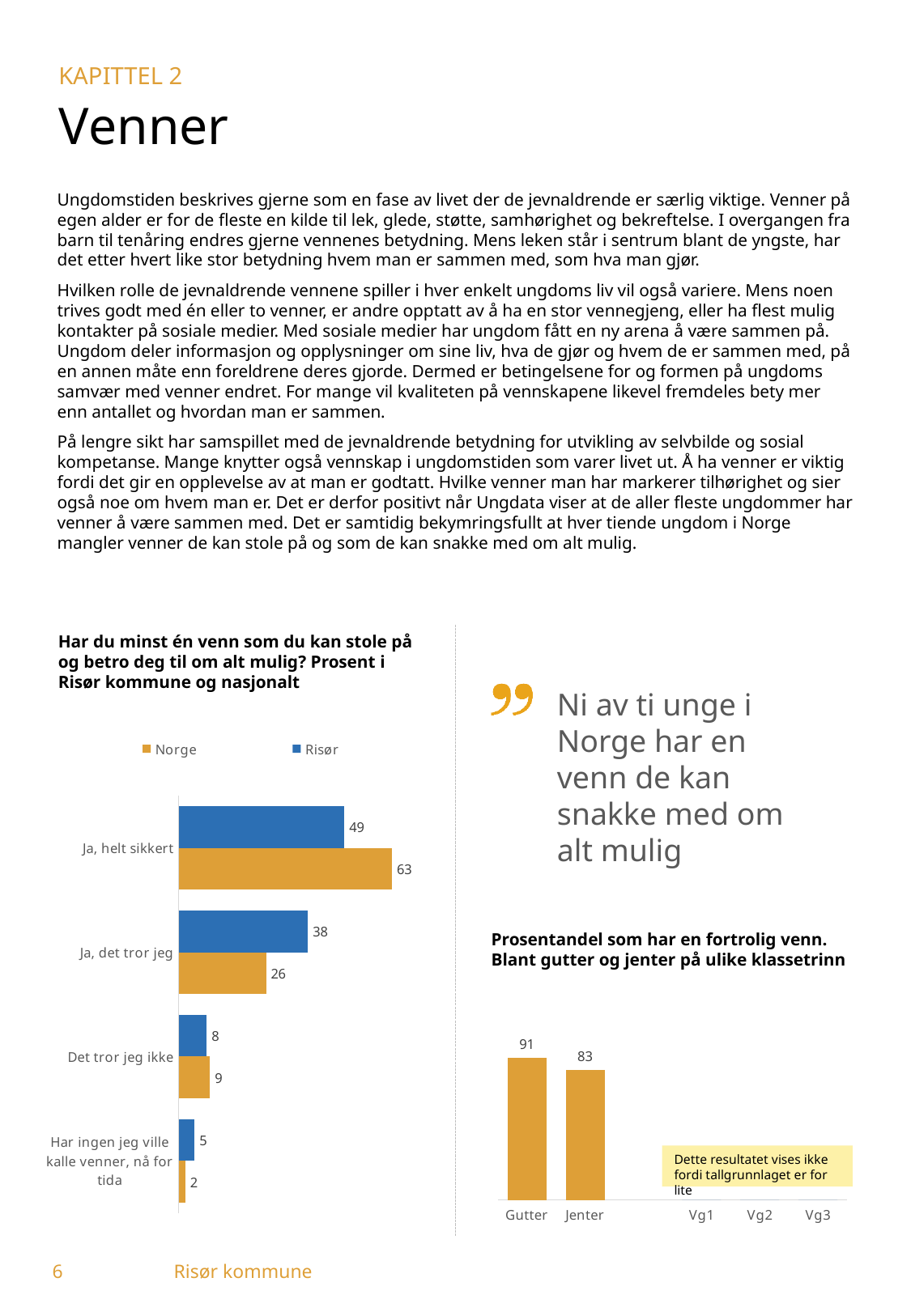
What kind of chart is 'Har du minst én venn som du kan stole på og betro deg til om alt mulig?'? Bar chart In the chart 'Prosentandel som har en fortrolig venn', what is the value for Gutter? 91 In the chart 'Har du minst én venn som du kan stole på og betro deg til om alt mulig?', how many series does the legend list? 2 In the chart 'Har du minst én venn som du kan stole på og betro deg til om alt mulig?', which category has the lowest value for Norge? Har ingen jeg ville kalle venner, nå for tida In the chart 'Har du minst én venn som du kan stole på og betro deg til om alt mulig?', which is larger for 'Ja, det tror jeg': Norge or Risør? Risør In the chart 'Prosentandel som har en fortrolig venn', what is the difference between the values for Gutter and Jenter? 8 In the chart 'Har du minst én venn som du kan stole på og betro deg til om alt mulig?', what is the value for Norge in the category 'Ja, det tror jeg'? 26 In the chart 'Har du minst én venn som du kan stole på og betro deg til om alt mulig?', what is the difference between the Norge and Risør values for 'Ja, helt sikkert'? 14 In the chart 'Har du minst én venn som du kan stole på og betro deg til om alt mulig?', which category has the highest value for Risør? Ja, helt sikkert In the chart 'Har du minst én venn som du kan stole på og betro deg til om alt mulig?', what is the value for Risør in the category 'Ja, helt sikkert'? 49 In the chart 'Har du minst én venn som du kan stole på og betro deg til om alt mulig?', what is the value for Norge in the category 'Ja, helt sikkert'? 63 In the chart 'Har du minst én venn som du kan stole på og betro deg til om alt mulig?', how many categories are shown? 4